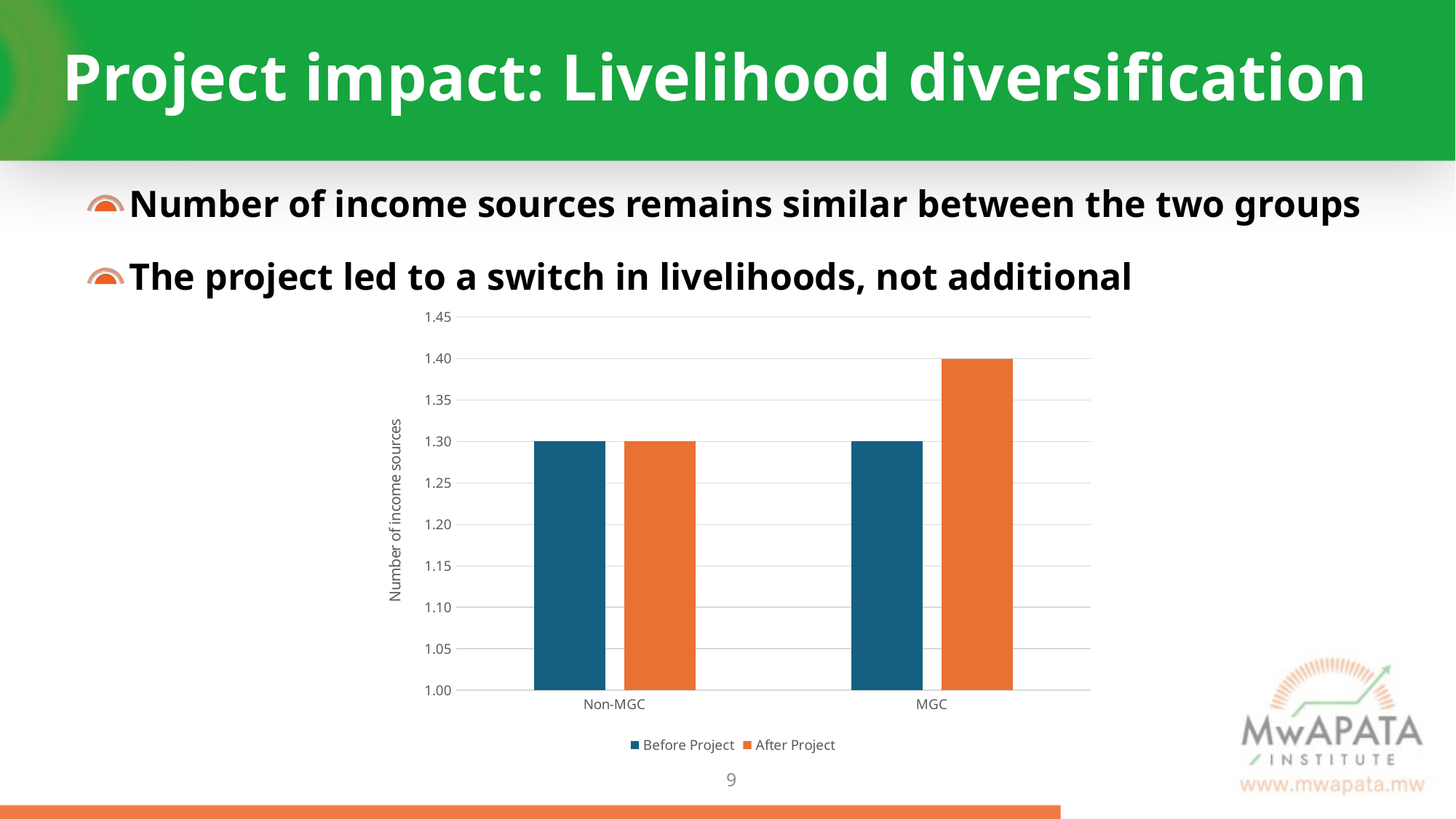
What is the label on the vertical axis of the chart? Number of income sources What is the difference between the After Project and Before Project values for MGC? 0.10 What is the value for After Project in the Non-MGC category? 1.30 Which is larger for MGC: the Before Project value or the After Project value? After Project What kind of chart is shown on the slide? bar chart How many categories are shown on the x axis of the chart? 2 What is the value for Before Project in the MGC category? 1.30 Is the After Project value for MGC greater or less than 1.35? greater Which bar in the chart is the highest? After Project, MGC What is the value for After Project in the MGC category? 1.40 What is the value for Before Project in the Non-MGC category? 1.30 How many series does the chart legend list? 2